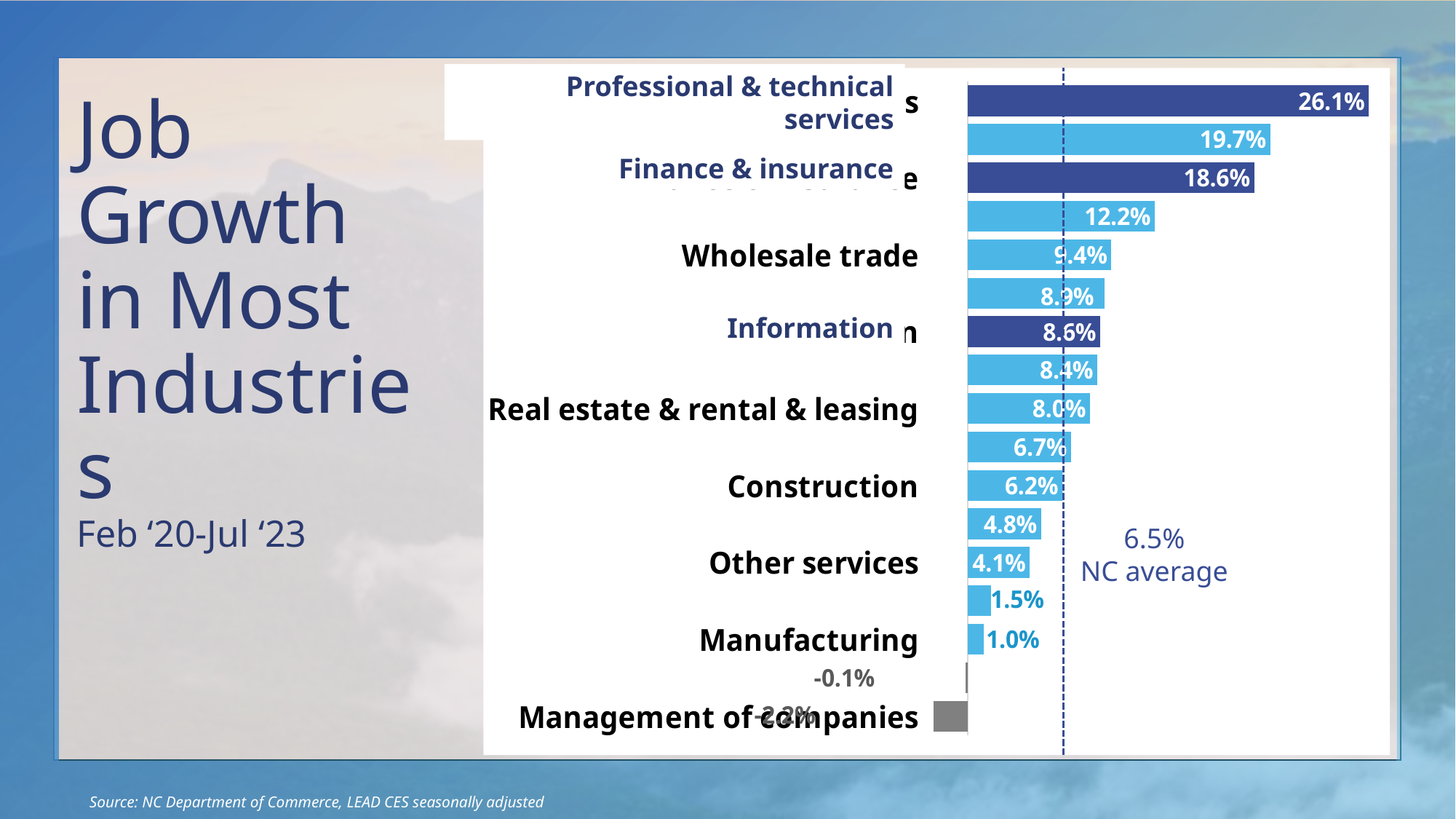
What NC average value is marked by the dashed line on the chart? 6.5% Which has higher job growth, Wholesale trade or Other services? Wholesale trade Which industry has the lowest job growth on the chart? Management of companies What is the job growth value for Manufacturing? 1.0% What is the job growth value for Construction? 6.2% What is the job growth value for Wholesale trade? 9.4% What is the job growth value for Finance & insurance? 18.6% What is the job growth value for Information? 8.6% Which industry has the highest job growth on the chart? Professional & technical services What is the difference in job growth between Professional & technical services and Finance & insurance? 7.5 percentage points What is the job growth value for Real estate & rental & leasing? 8.0% What is the job growth value for Professional & technical services? 26.1%